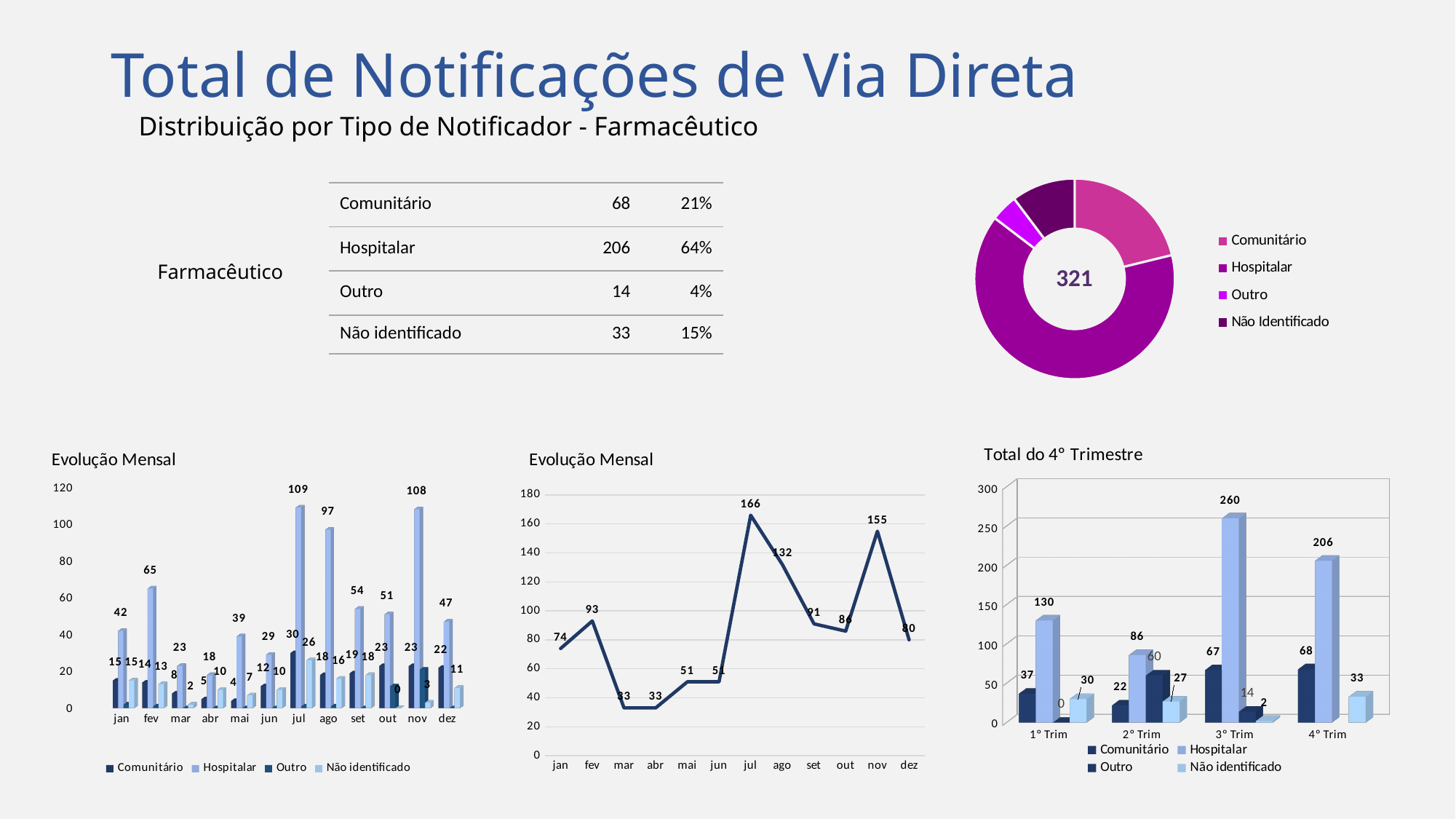
What kind of chart is the 'Evolução Mensal' chart at the bottom left? bar chart On the 'Evolução Mensal' bar chart at the bottom left, what is the Hospitalar value for jul? 109 On the 'Evolução Mensal' line chart in the middle, what is the value for jul? 166 On the 'Evolução Mensal' line chart in the middle, is the value for set greater or less than 100? less On the 'Total do 4° Trimestre' chart, which is larger, the Hospitalar value for 3° Trim or for 4° Trim? 3° Trim On the donut chart at the top right, what total is shown in the centre? 321 On the 'Evolução Mensal' line chart in the middle, which month has the highest value? jul How many entries does the legend of the donut chart at the top right list? 4 On the 'Total do 4° Trimestre' chart, what is the Hospitalar value for 3° Trim? 260 On the 'Evolução Mensal' line chart in the middle, does the value rise or fall from jul to ago? fall On the 'Evolução Mensal' line chart in the middle, how many months are plotted? 12 On the 'Evolução Mensal' line chart in the middle, what is the difference between the values for jul and nov? 11